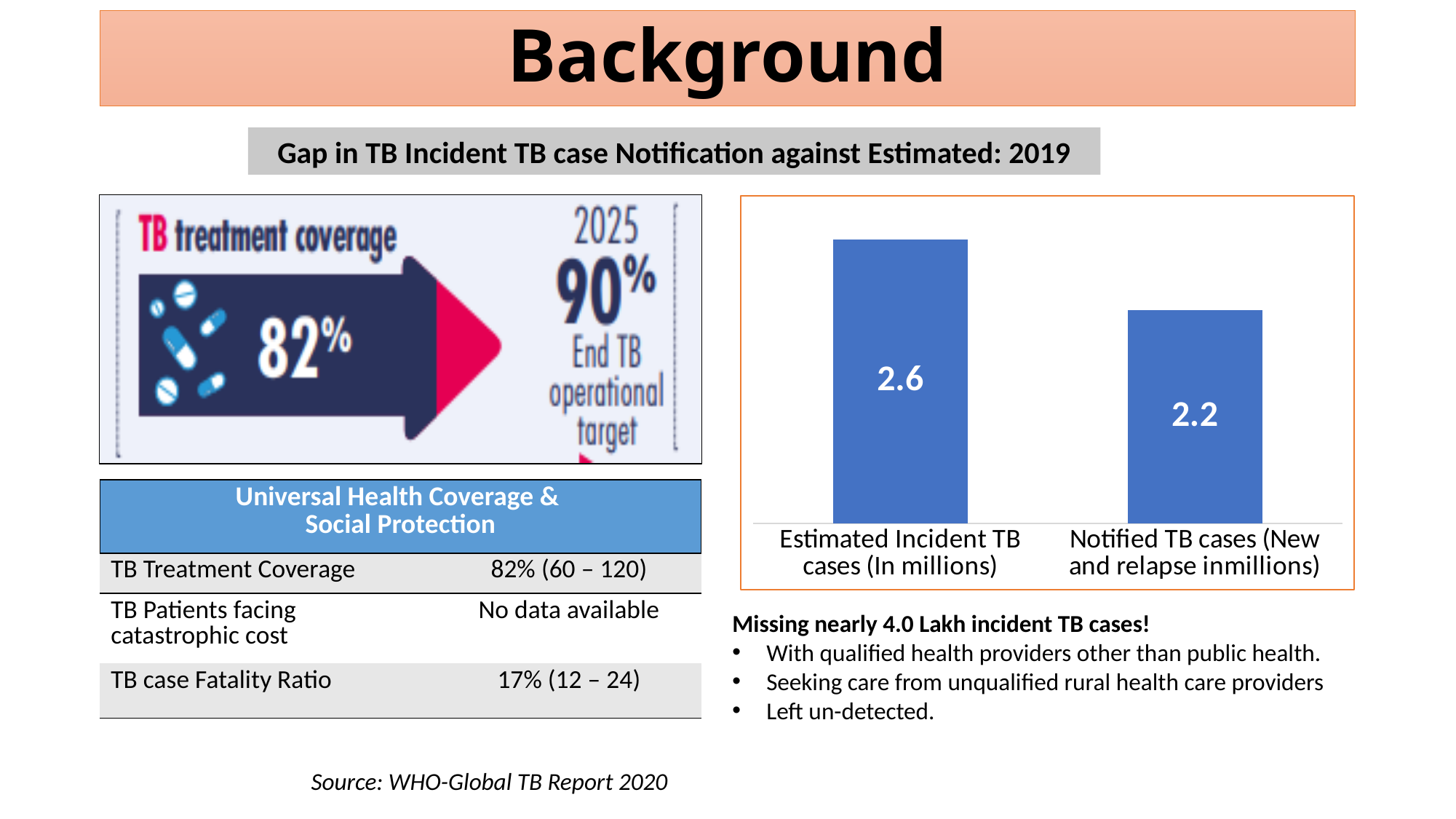
How many bars are shown in the chart? 2 What is the value for Notified TB cases (New and relapse in millions)? 2.2 What is the value for Estimated Incident TB cases (In millions)? 2.6 What is the difference between the Estimated Incident TB cases and the Notified TB cases values? 0.4 Do the values rise or fall from the left bar to the right bar? Fall What is the heading above the bar chart? Gap in TB Incident TB case Notification against Estimated: 2019 Which is larger: Estimated Incident TB cases or Notified TB cases? Estimated Incident TB cases What colour are the bars in the chart? Blue Which category has the lowest value in the bar chart? Notified TB cases (New and relapse in millions) What kind of chart is shown on the right of the slide? Bar chart Which category has the highest value in the bar chart? Estimated Incident TB cases (In millions)